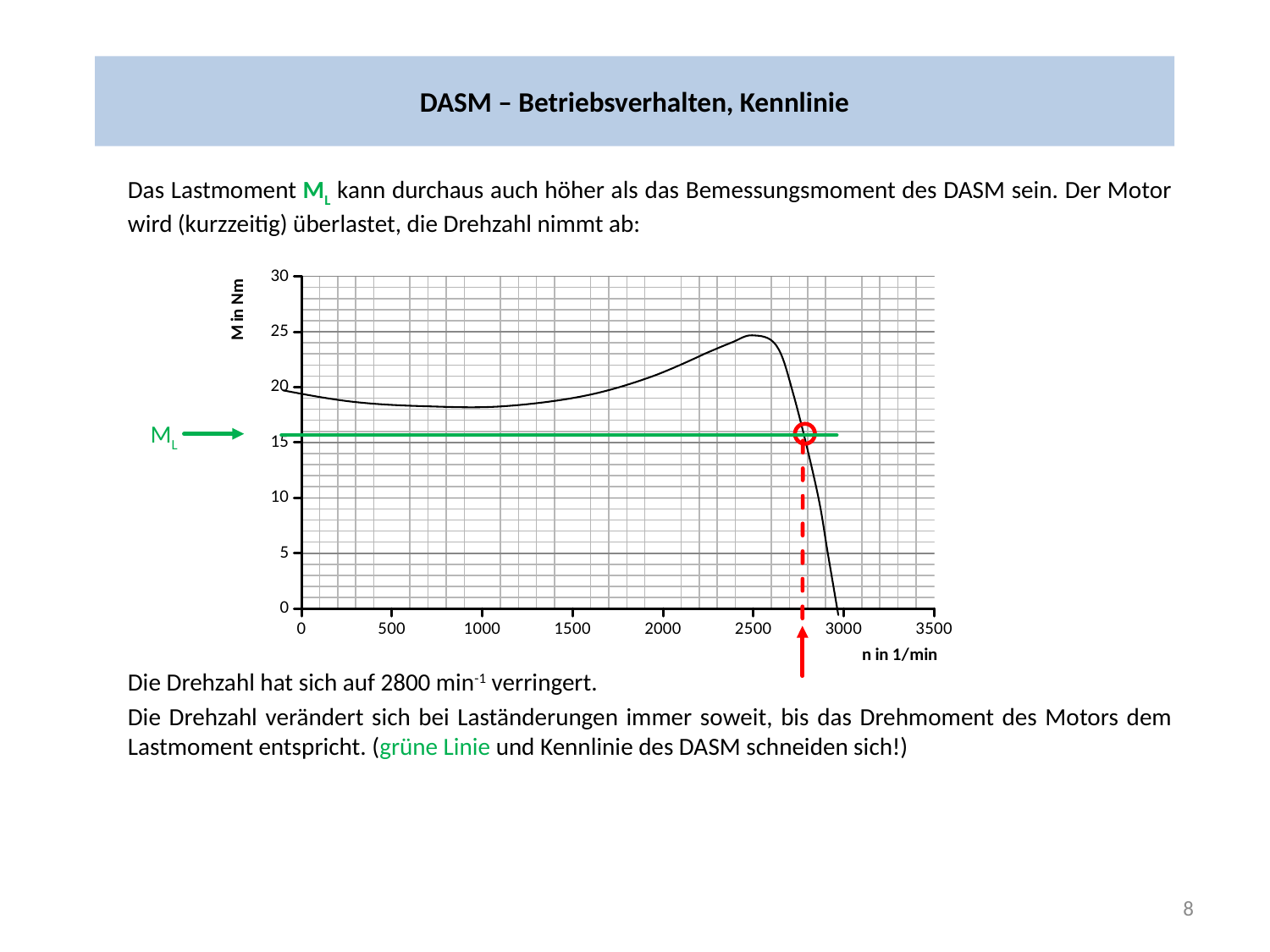
According to the slide, at what speed does the green line M_L intersect the motor characteristic curve? 2800 min-1 What is the label of the vertical axis of the chart? M in Nm Is the torque value of the black curve at n = 0 greater or less than 15? greater Does the black curve rise or fall between n = 2500 and n = 3000? fall Does the black curve rise or fall between n = 1000 and n = 2500? rise What kind of chart is shown on the slide? line chart Is the torque value of the black curve at n = 1000 greater or less than 20? less Is the torque value of the black curve at n = 2500 greater or less than 20? greater What is the label of the horizontal axis of the chart? n in 1/min